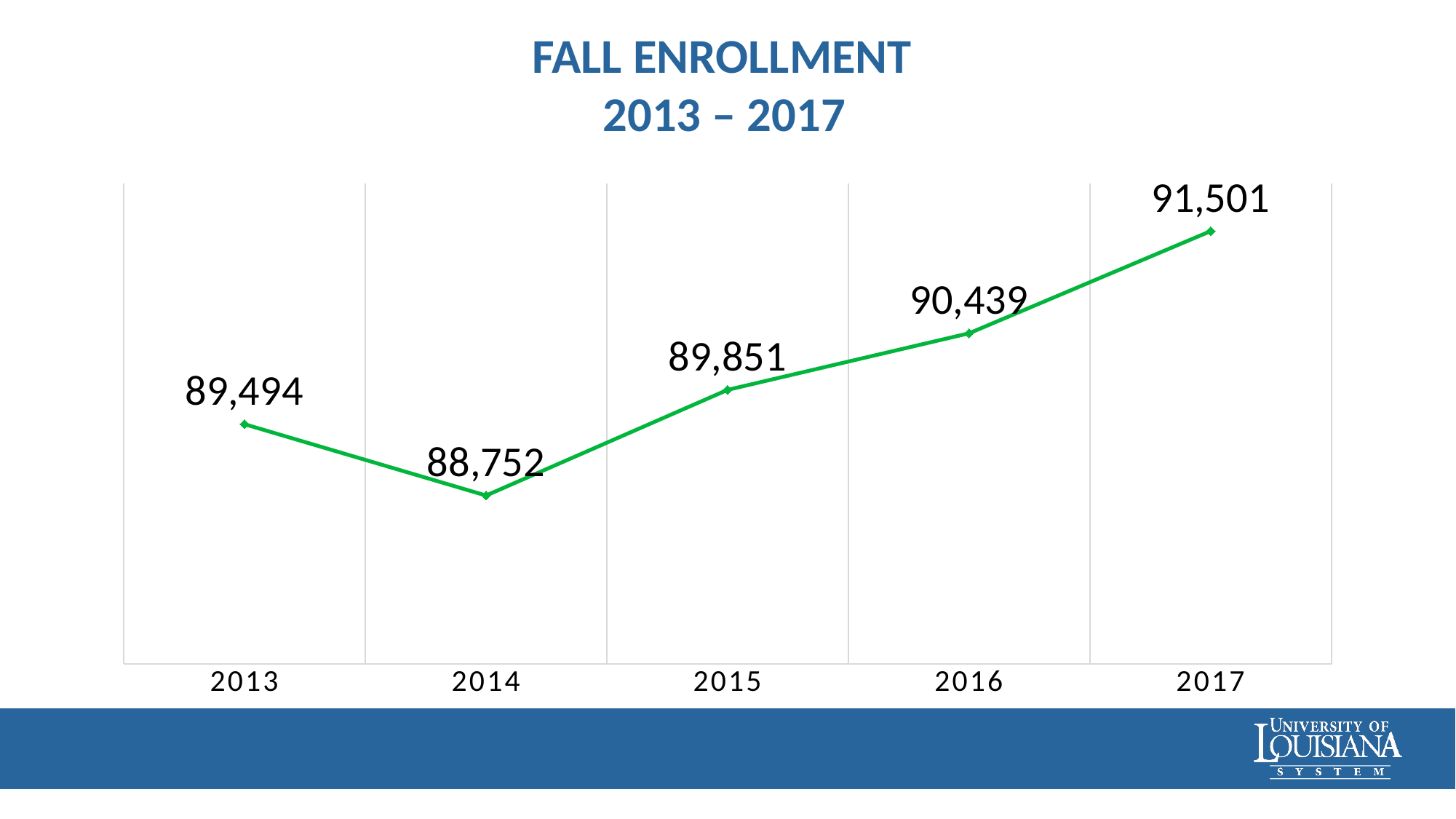
Which year had the highest fall enrollment? 2017 What was the fall enrollment in 2016? 90,439 What kind of chart is shown on the slide? Line chart What was the fall enrollment in 2013? 89,494 Which year had the lowest fall enrollment? 2014 What was the fall enrollment in 2015? 89,851 How many years are plotted on the chart? 5 What is the difference in fall enrollment between 2017 and 2016? 1,062 What is the difference in fall enrollment between 2013 and 2014? 742 What was the fall enrollment in 2017? 91,501 Which year had higher fall enrollment, 2013 or 2015? 2015 What was the fall enrollment in 2014? 88,752